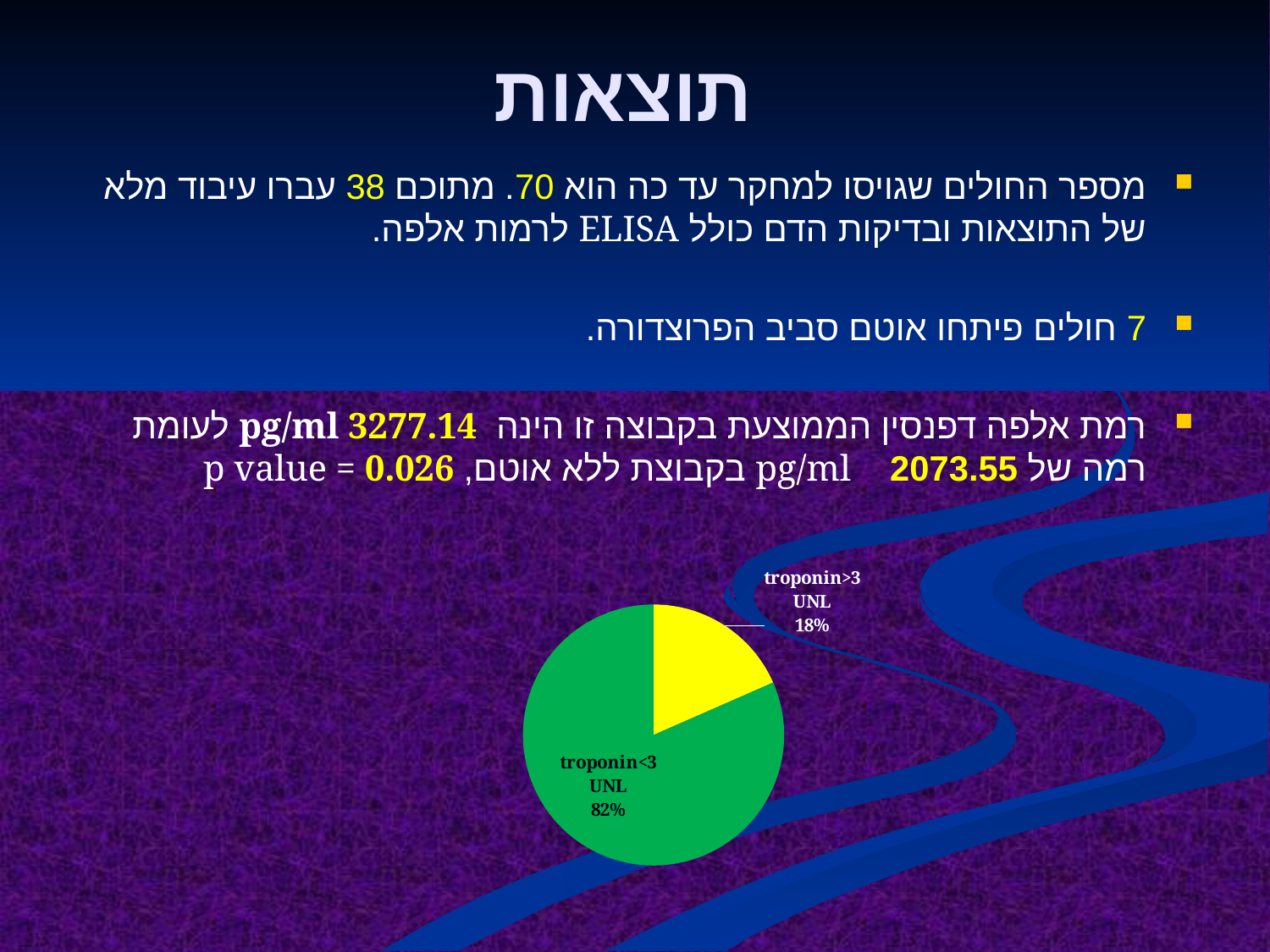
What is the difference in percentage points between the troponin<3 UNL slice and the troponin>3 UNL slice? 64 Which is larger, the troponin>3 UNL slice or the troponin<3 UNL slice? troponin<3 UNL What share of the pie does the troponin>3 UNL slice represent? 18% What colour is the troponin>3 UNL slice in the pie chart? yellow Which slice of the pie chart is the smallest? troponin>3 UNL Which slice of the pie chart is the largest? troponin<3 UNL What colour is the troponin<3 UNL slice in the pie chart? green What share of the pie does the troponin<3 UNL slice represent? 82% How many slices does the pie chart have? 2 What kind of chart is shown on the slide? pie chart